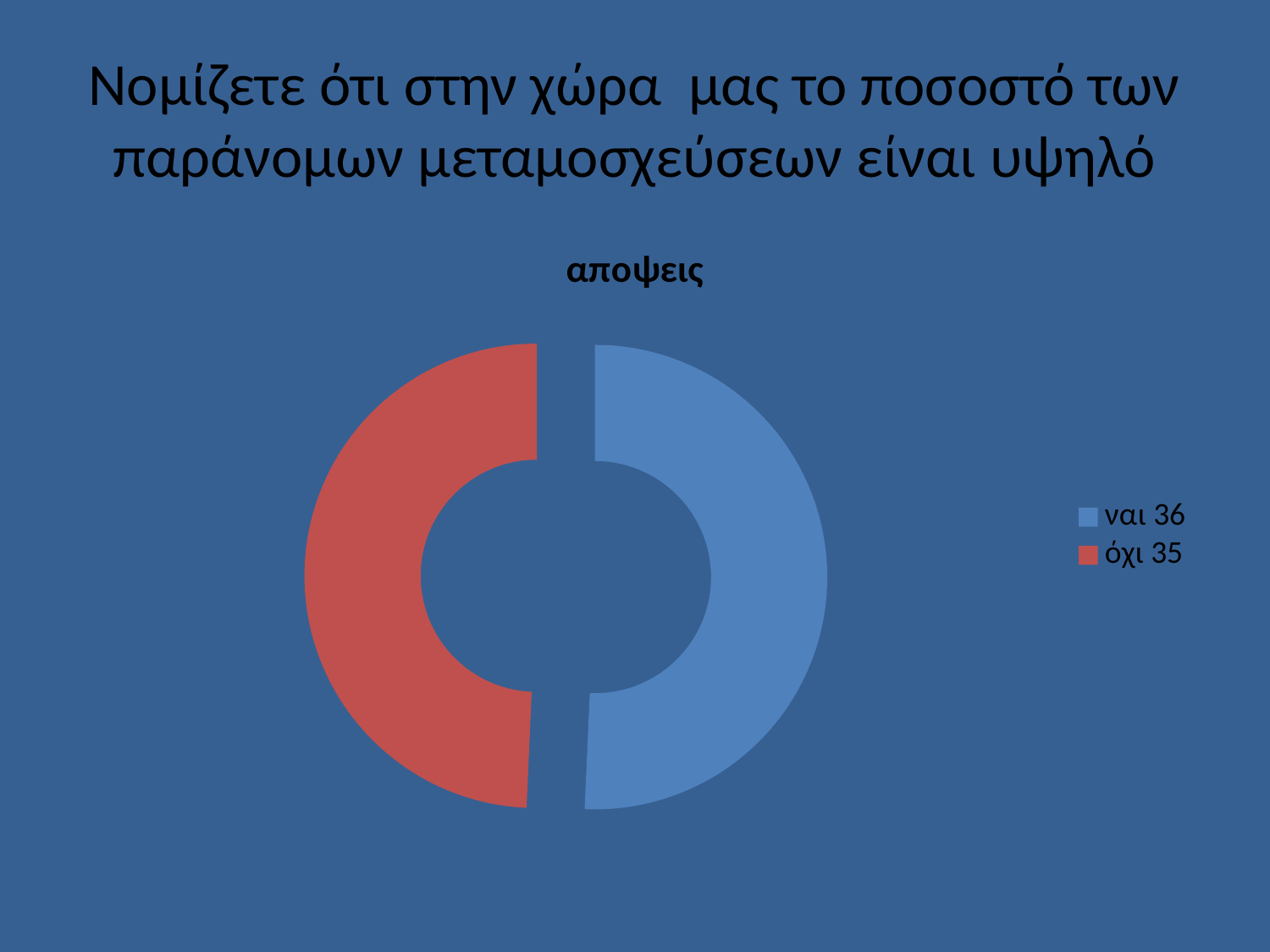
Which category has the smallest value in the chart? όχι Which category has the largest value in the chart? ναι What is the title of the chart? αποψεις What kind of chart is shown on the slide? Doughnut chart What is the value for όχι in the chart? 35 What is the difference between the values for ναι and όχι? 1 How many categories does the chart show? 2 What colour represents όχι in the chart? Red Which category has the higher value, ναι or όχι? ναι What is the total of the values for ναι and όχι? 71 What is the value for ναι in the chart? 36